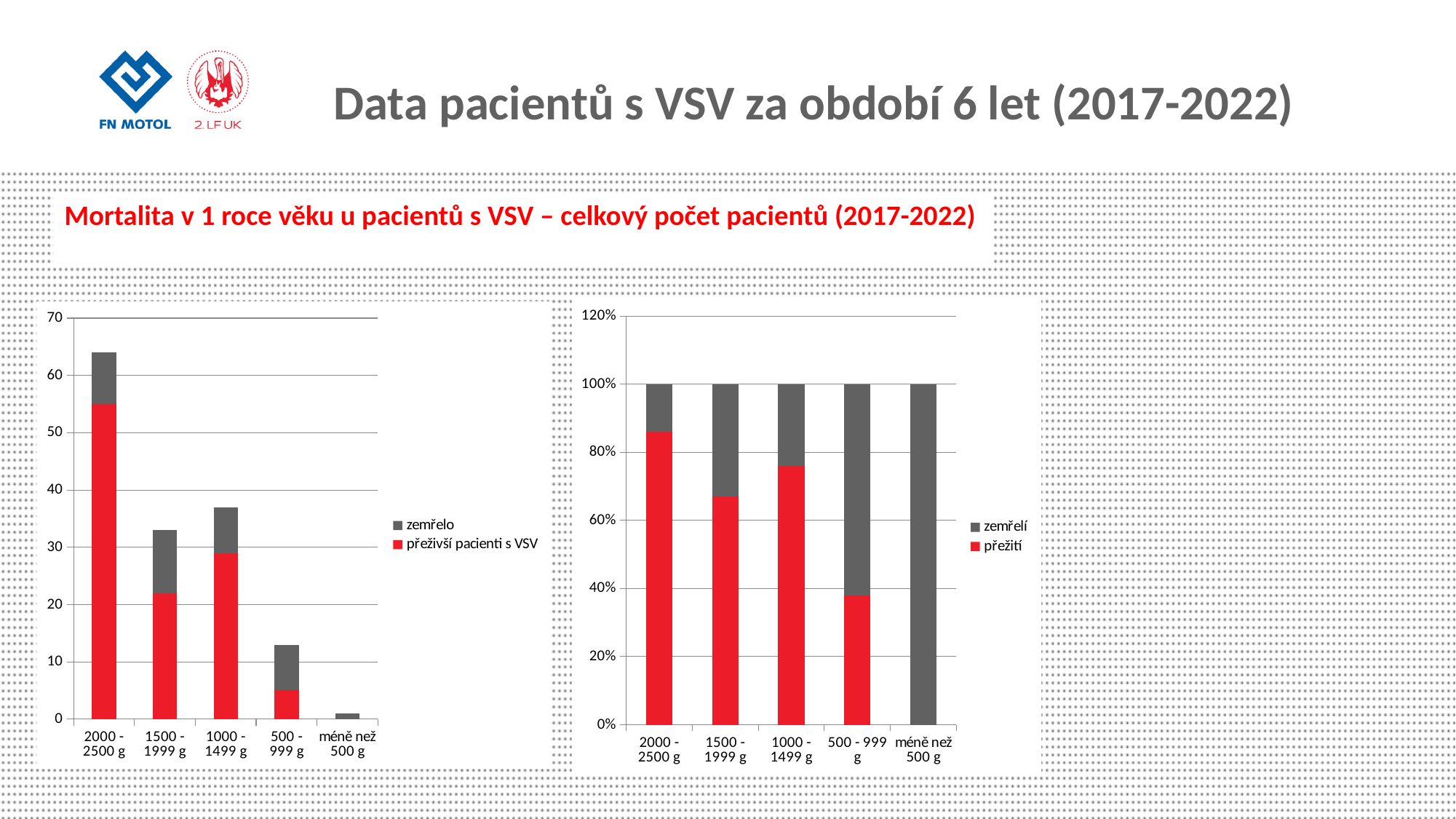
In the left chart, do the total bar heights rise or fall moving from 2000 - 2500 g to méně než 500 g? fall In the left chart, is the total height of the bar for 2000 - 2500 g greater or less than 60? greater What kind of chart is the left chart on the slide? bar chart How many series does the legend of the left chart list? 2 How many weight categories are shown on the x axis of the left chart? 5 In the right chart, is the přežití share for 2000 - 2500 g greater or less than 80%? greater In the left chart, which weight category has the tallest stacked bar? 2000 - 2500 g In the left chart, which weight category has the shortest stacked bar? méně než 500 g In the right chart, which series is shown in red according to the legend? přežití In the left chart, is the total height of the bar for 500 - 999 g greater or less than 10? greater